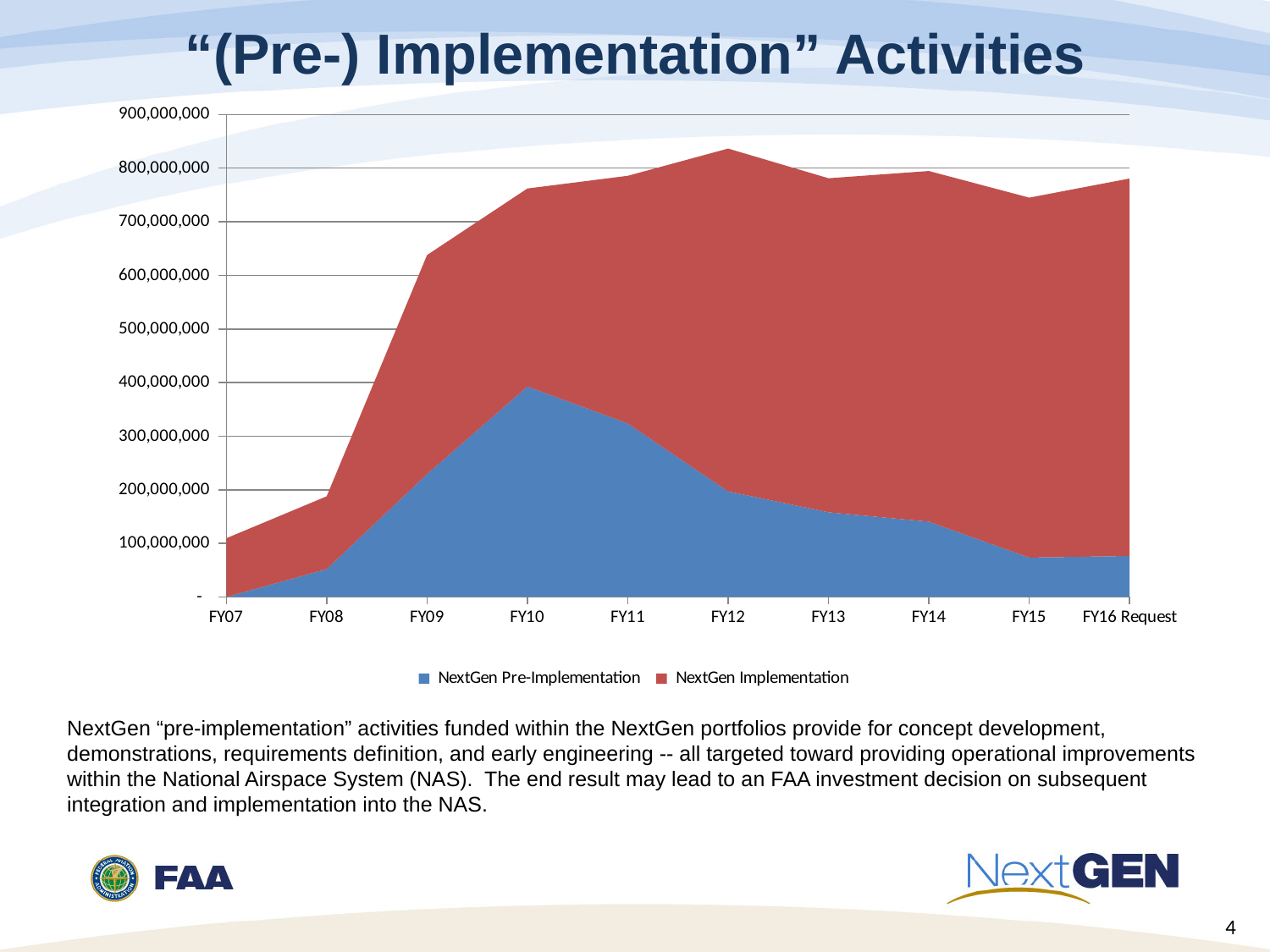
In which fiscal year is NextGen Pre-Implementation at its lowest value? FY07 How many series does the legend list? 2 Is the NextGen Pre-Implementation value for FY10 greater or less than 300,000,000? greater In which fiscal year does NextGen Pre-Implementation reach its highest value? FY10 What is the label of the last category on the x axis? FY16 Request Is the combined total of both series for FY12 greater or less than 800,000,000? greater Is the NextGen Pre-Implementation value for FY15 greater or less than 100,000,000? less Which series is shown in blue in the legend? NextGen Pre-Implementation How many fiscal-year categories are shown on the x axis? 10 Which is larger, the NextGen Pre-Implementation value for FY10 or for FY11? FY10 What kind of chart is shown on the slide? Area chart Does the NextGen Pre-Implementation value rise or fall from FY10 to FY15? fall